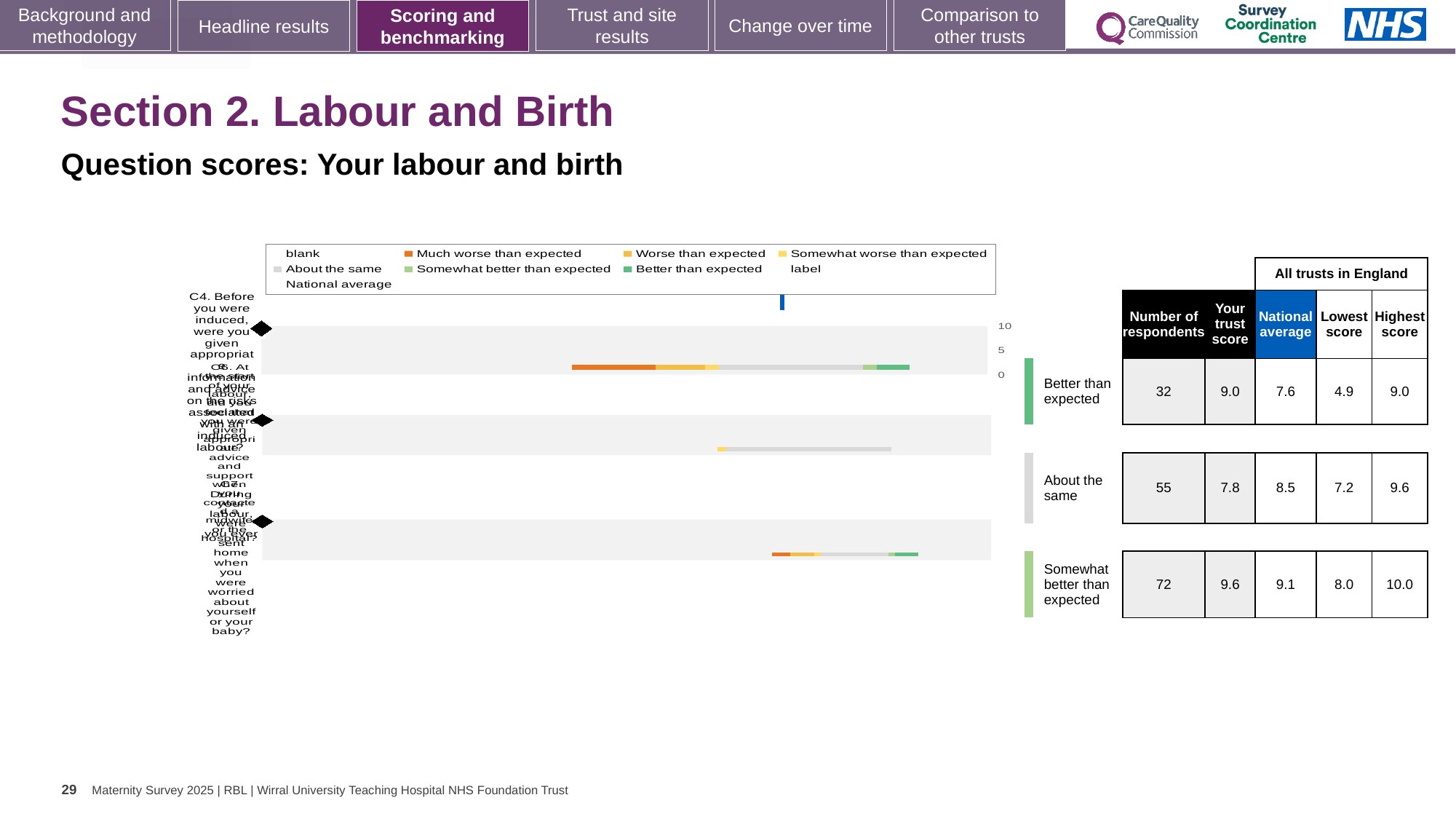
In the table beside the chart, for the row marked 'About the same', which is larger: the trust score or the national average? National average In the table beside the chart, what is the national average for the row marked 'Somewhat better than expected'? 9.1 In the table beside the chart, which row has the lowest 'Lowest score'? Better than expected In the chart legend, what colour represents 'Better than expected'? green In the table beside the chart, which row has the largest number of respondents? Somewhat better than expected In the table beside the chart, what is the difference between the trust score and the national average for the row marked 'Better than expected'? 1.4 In the table beside the chart, what is the trust score for the row marked 'About the same'? 7.8 In the table beside the chart, what is the highest score for the row marked 'Somewhat better than expected'? 10.0 In the chart legend, what colour represents 'Much worse than expected'? orange What kind of chart is shown on the slide? bar chart In the table beside the chart, what is the number of respondents for the row marked 'Better than expected'? 32 How many horizontal bars are plotted in the chart? 3